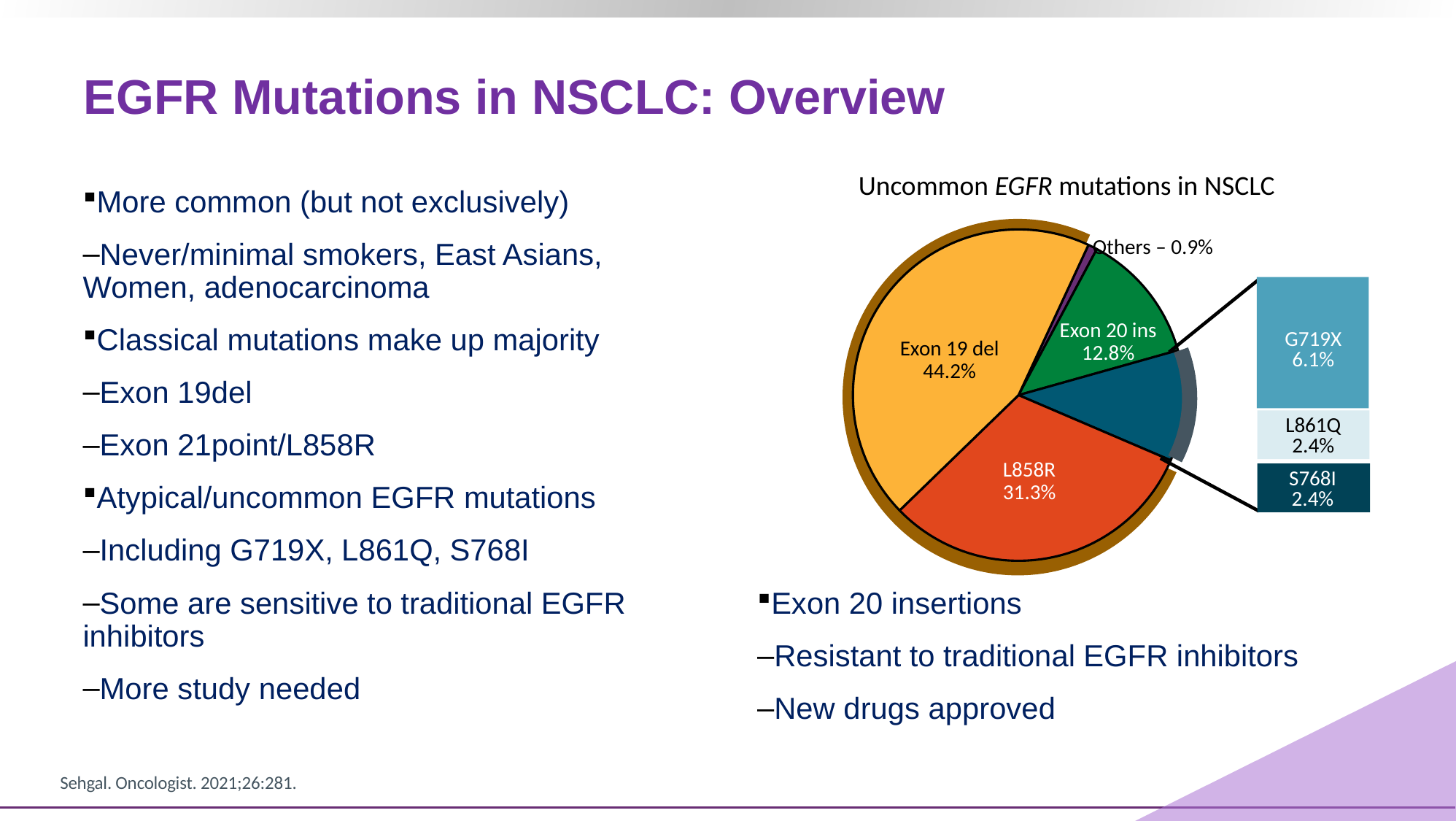
Which labelled slice of the pie is the smallest? Others What share of the pie does Exon 19 del represent? 44.2% What kind of chart is shown on the slide? pie chart What percentage is shown for G719X in the breakout of the pie? 6.1% What percentage is shown for Others? 0.9% What share of the pie does L858R represent? 31.3% Which slice of the pie is the largest? Exon 19 del What is the title of the chart? Uncommon EGFR mutations in NSCLC Which is larger, the share for Exon 20 ins or the share for G719X? Exon 20 ins What percentage is shown for L861Q in the breakout of the pie? 2.4% What is the difference in percentage points between Exon 19 del and L858R? 12.9 What percentage is shown for Exon 20 ins? 12.8%